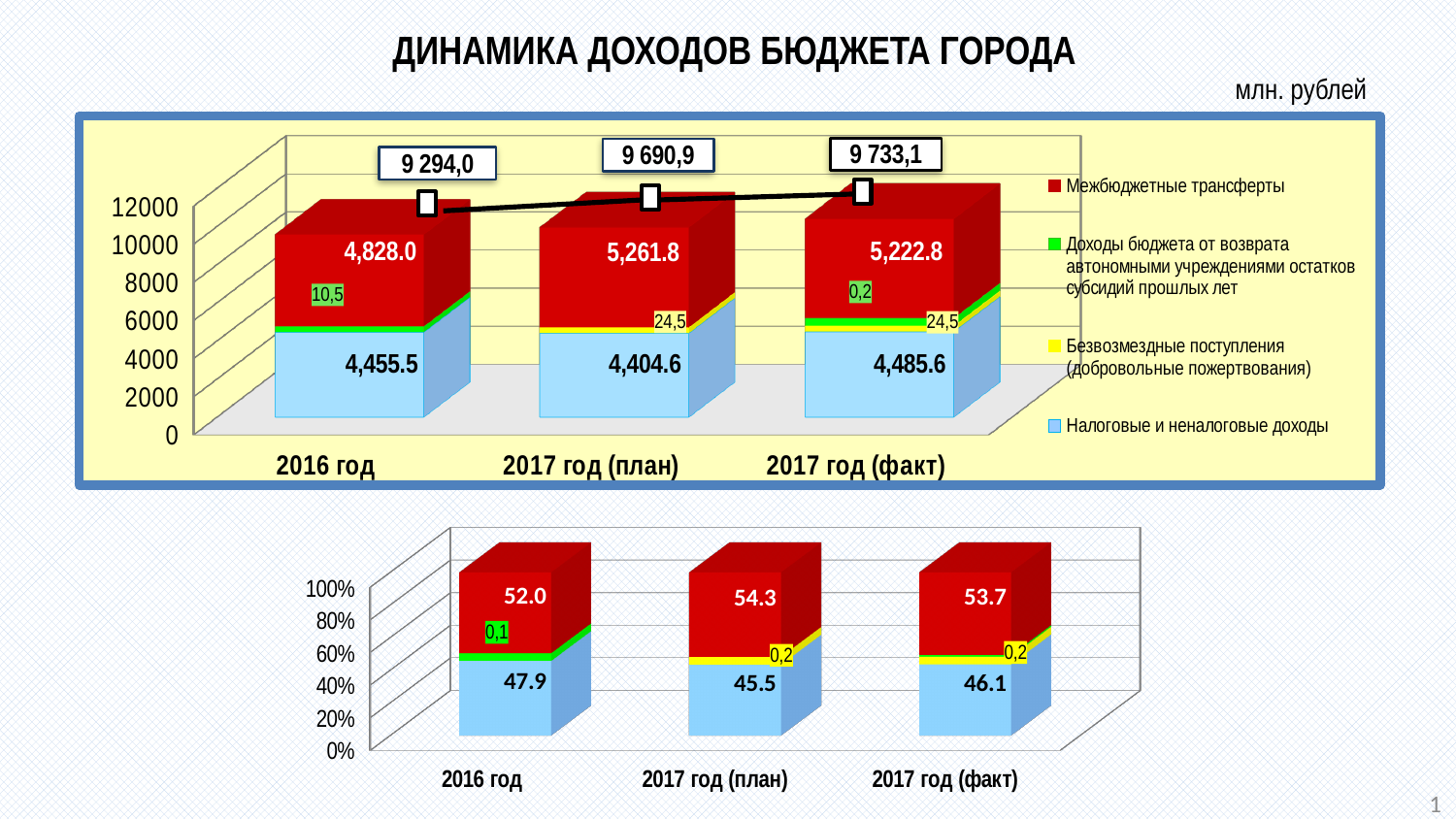
How many series does the legend of the top chart list? 4 What type of chart is the top chart? Stacked bar chart In the top chart, is the Межбюджетные трансферты value larger for 2017 год (план) or 2017 год (факт)? 2017 год (план) In the top chart, what is the value of Налоговые и неналоговые доходы for 2017 год (план)? 4,404.6 In the top chart, what total is shown above the bar for 2017 год (факт)? 9 733,1 In the top chart, which category has the lowest value for Налоговые и неналоговые доходы? 2017 год (план) In the top chart, what is the value of Межбюджетные трансферты for 2016 год? 4,828.0 In the bottom chart, what is the percentage share of Межбюджетные трансферты for 2017 год (план)? 54.3 How many categories are shown on the x axis of the bottom chart? 3 In the bottom chart, what is the value of Налоговые и неналоговые доходы for 2016 год? 47.9 In the top chart, which category has the highest total shown above its bar? 2017 год (факт) In the top chart, what is the difference between the Межбюджетные трансферты values for 2017 год (план) and 2016 год? 433.8